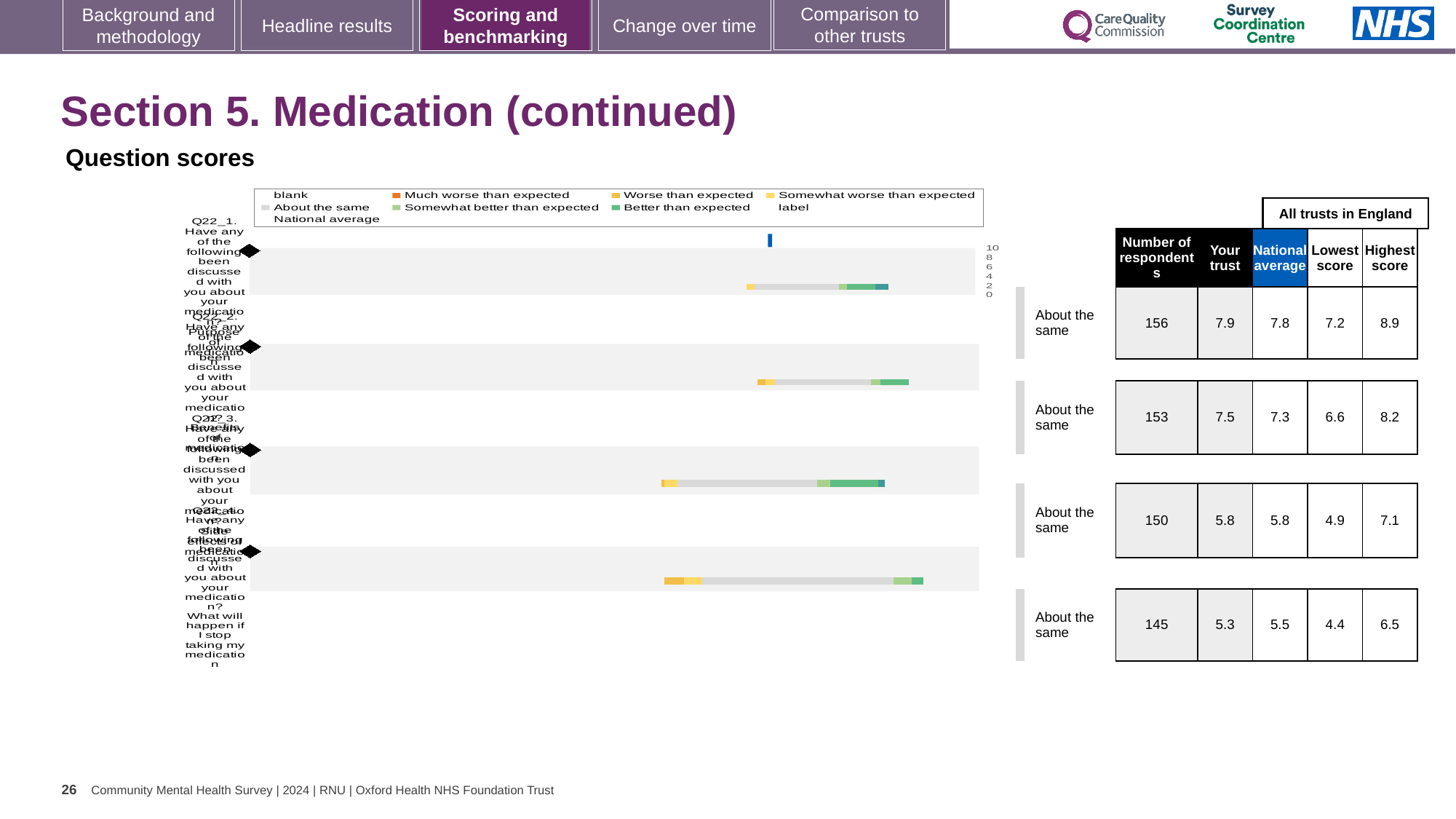
What is the national average for the top question row? 7.8 What kind of chart is shown under 'Question scores'? bar chart What is the difference between 'Your trust' and the national average for the top question row? 0.1 For the bottom question row, which is larger: the 'Your trust' score or the national average? national average How many respondents are listed for the second question row? 153 What benchmark category is shown next to each of the four question bars? About the same What is the highest score for the third question row? 7.1 What is the 'Your trust' score for the top question row in the table beside the chart? 7.9 Which question row has the highest 'Your trust' score? the top row (7.9) Which question row has the fewest respondents? the bottom row (145) How many question bars are plotted in the chart? 4 What is the lowest score for the bottom question row? 4.4